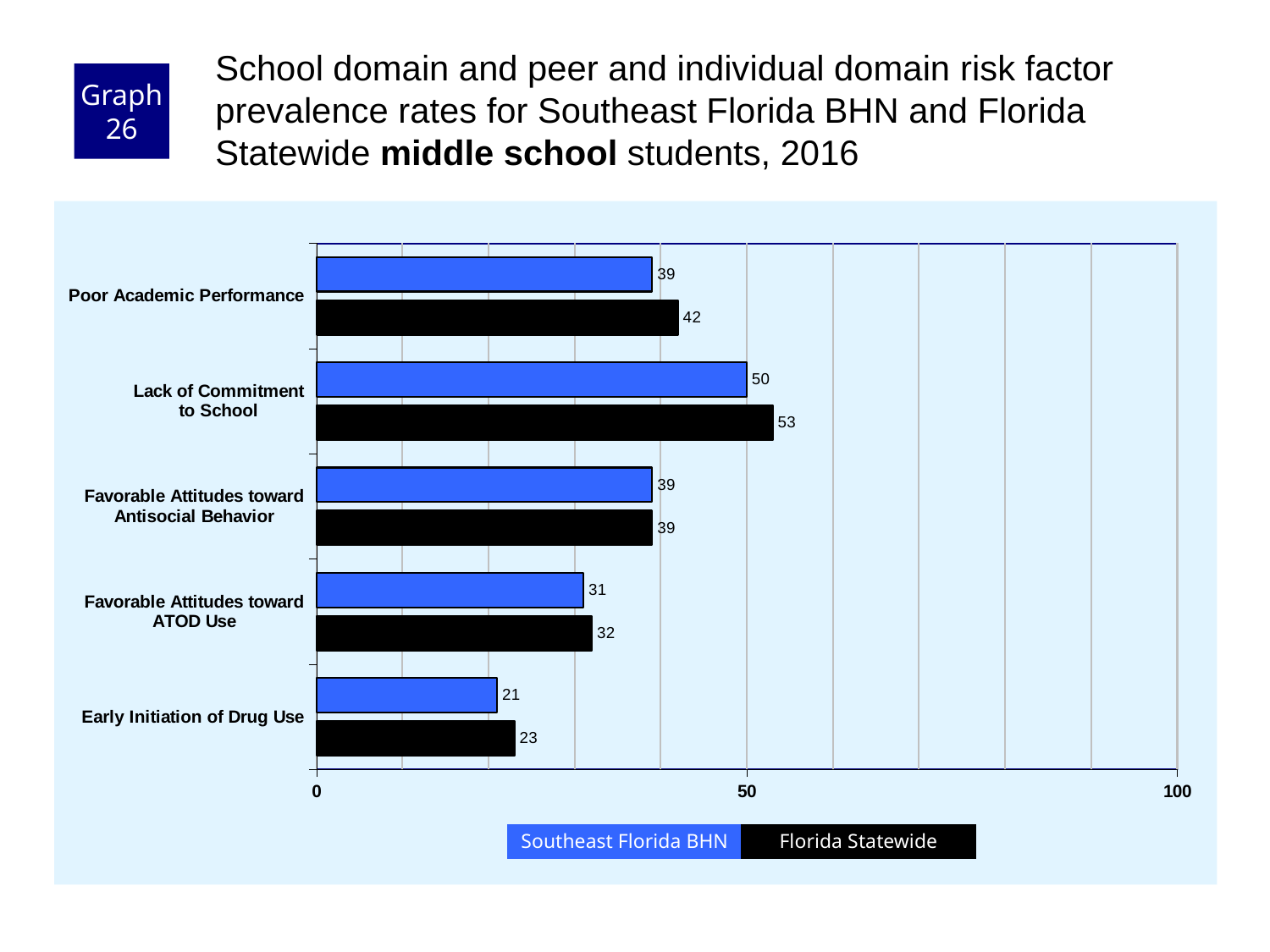
What kind of chart is shown on the slide? bar chart What is the Southeast Florida BHN value for Early Initiation of Drug Use? 21 What is the difference between the Florida Statewide and Southeast Florida BHN values for Poor Academic Performance? 3 Which risk factor has the highest Florida Statewide value? Lack of Commitment to School How many series does the legend list? 2 What is the Southeast Florida BHN value for Poor Academic Performance? 39 How many risk factor categories are shown on the chart? 5 What is the Florida Statewide value for Favorable Attitudes toward ATOD Use? 32 Which is larger for Lack of Commitment to School: the Southeast Florida BHN value or the Florida Statewide value? Florida Statewide Which risk factor has the lowest Southeast Florida BHN value? Early Initiation of Drug Use Is the Florida Statewide value for Early Initiation of Drug Use greater or less than 50? less What is the Florida Statewide value for Lack of Commitment to School? 53